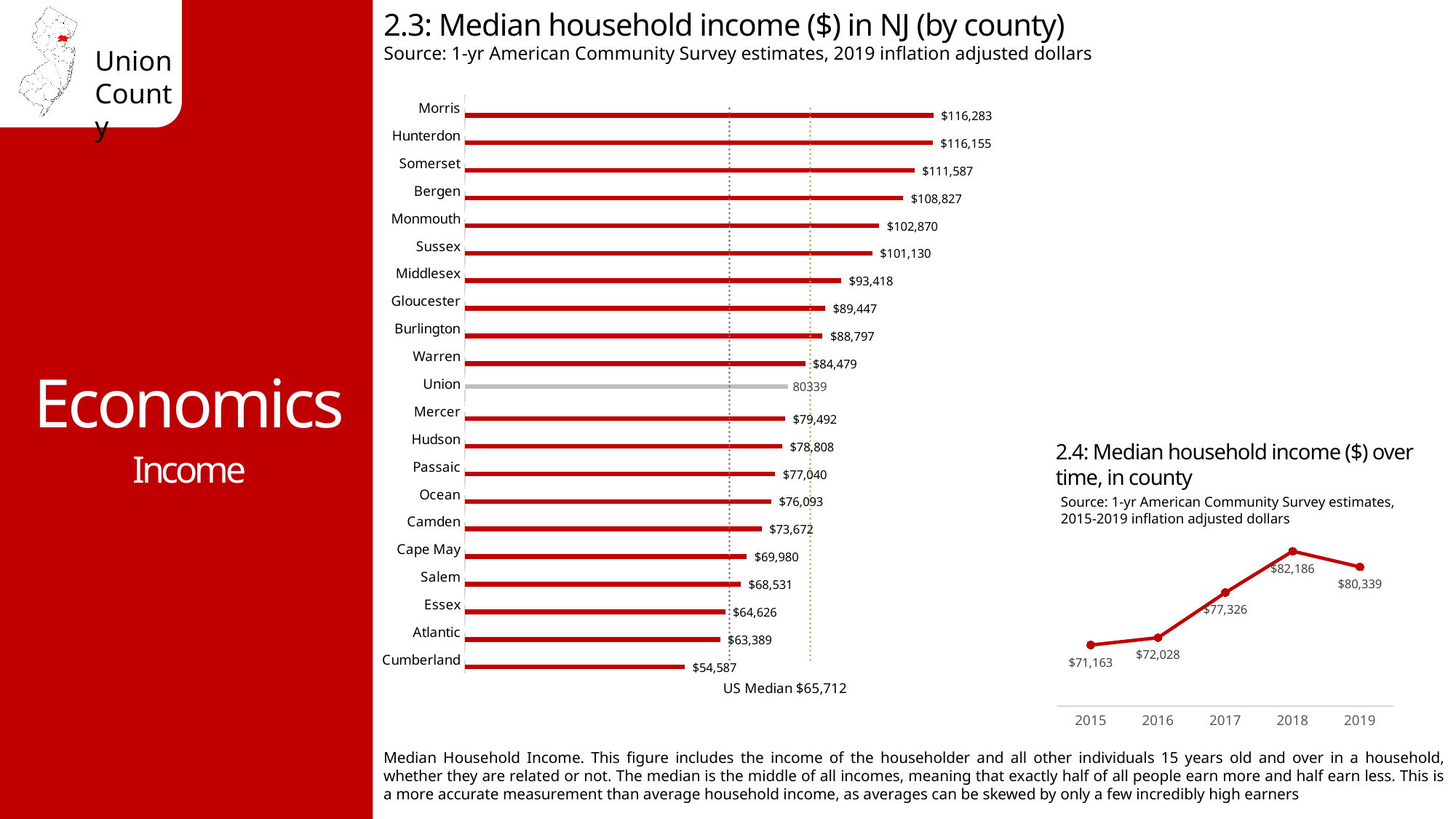
In chart 2.4 (Median household income over time, in county), what is the difference between 2018 and 2019? $1,847 In chart 2.3 (Median household income in NJ by county), which county has the highest median household income? Morris In chart 2.4 (Median household income over time, in county), how many years are plotted? 5 In chart 2.3 (Median household income in NJ by county), what is the median household income for Morris? $116,283 In chart 2.3 (Median household income in NJ by county), how many counties are plotted? 21 In chart 2.3 (Median household income in NJ by county), what US median value is noted on the chart? $65,712 In chart 2.3 (Median household income in NJ by county), what value is shown for Union? 80339 In chart 2.4 (Median household income over time, in county), what kind of chart is shown? Line chart In chart 2.4 (Median household income over time, in county), which year has the highest value? 2018 In chart 2.3 (Median household income in NJ by county), which county has the lowest median household income? Cumberland In chart 2.3 (Median household income in NJ by county), what is the difference between Somerset and Bergen? $2,760 In chart 2.4 (Median household income over time, in county), what is the value for 2017? $77,326